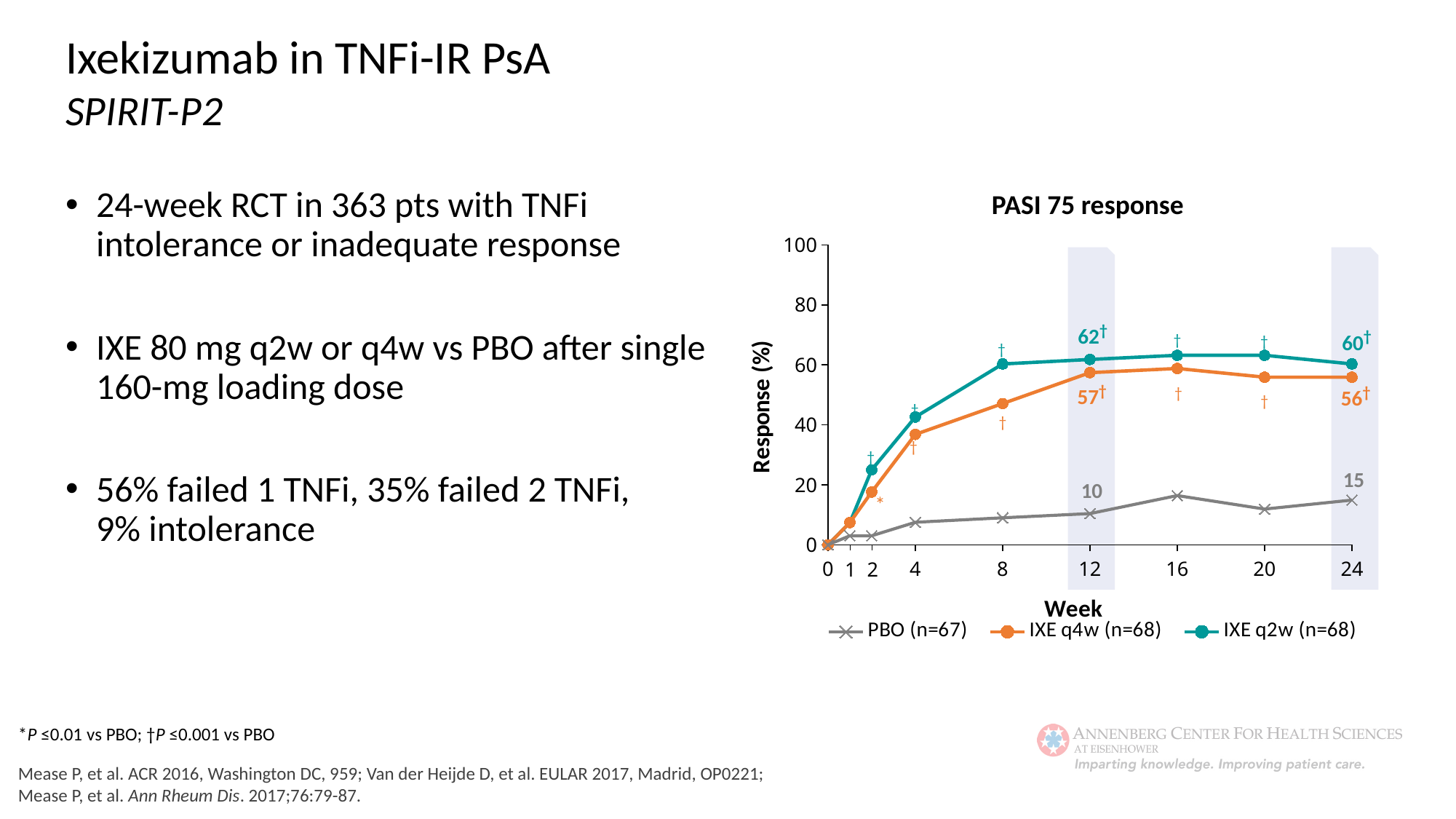
What kind of chart is shown? Line chart What is the PASI 75 response for IXE q2w at week 12? 62 What is the PASI 75 response for PBO at week 24? 15 Is the value for IXE q2w at week 8 greater or less than 40? greater What is the difference between the IXE q2w and PBO PASI 75 response at week 24? 45 Which series has the highest PASI 75 response at week 24? IXE q2w (n=68) What is the PASI 75 response for PBO at week 12? 10 What is the PASI 75 response for IXE q4w at week 24? 56 How many series does the legend list? 3 Does the PBO PASI 75 response rise or fall from week 0 to week 24? Rise Is the PASI 75 response for IXE q4w at week 12 larger than for PBO at week 12? Yes Which series has the lowest PASI 75 response at week 12? PBO (n=67)